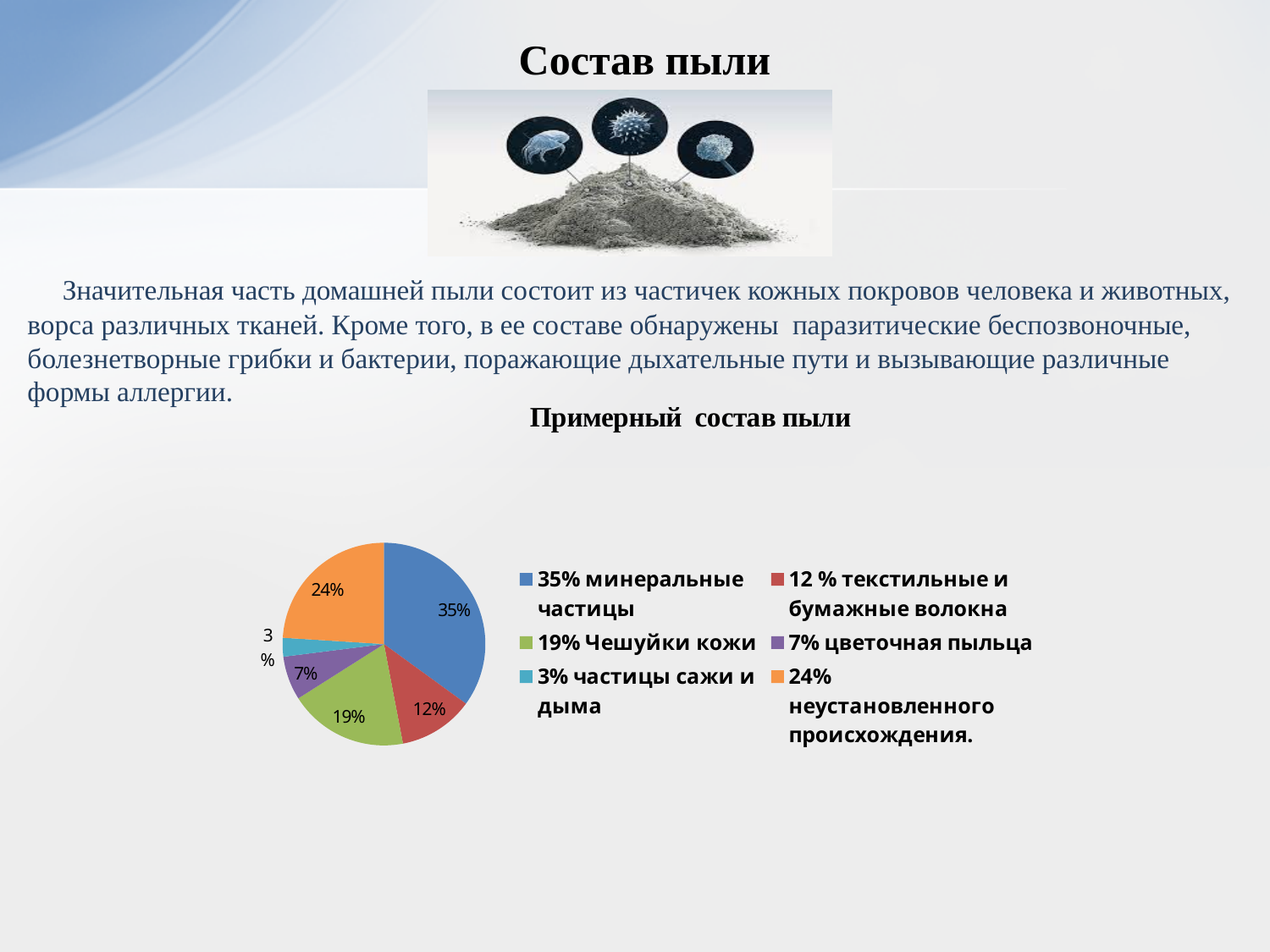
What share of the pie is labelled for частицы сажи и дыма? 3% How many slices does the pie chart have? 6 What share of the pie is labelled for Чешуйки кожи? 19% What is the difference between the share for минеральные частицы and the share for Чешуйки кожи? 16% Which category has the largest slice of the pie? минеральные частицы What type of chart is shown on the slide? Pie chart What share of the pie is labelled for минеральные частицы? 35% What colour is the slice for неустановленного происхождения? Orange Which is larger: the share for текстильные и бумажные волокна or the share for цветочная пыльца? текстильные и бумажные волокна Which category has the smallest slice of the pie? частицы сажи и дыма What is the title of the chart on the slide? Примерный состав пыли What share of the pie is labelled for неустановленного происхождения? 24%